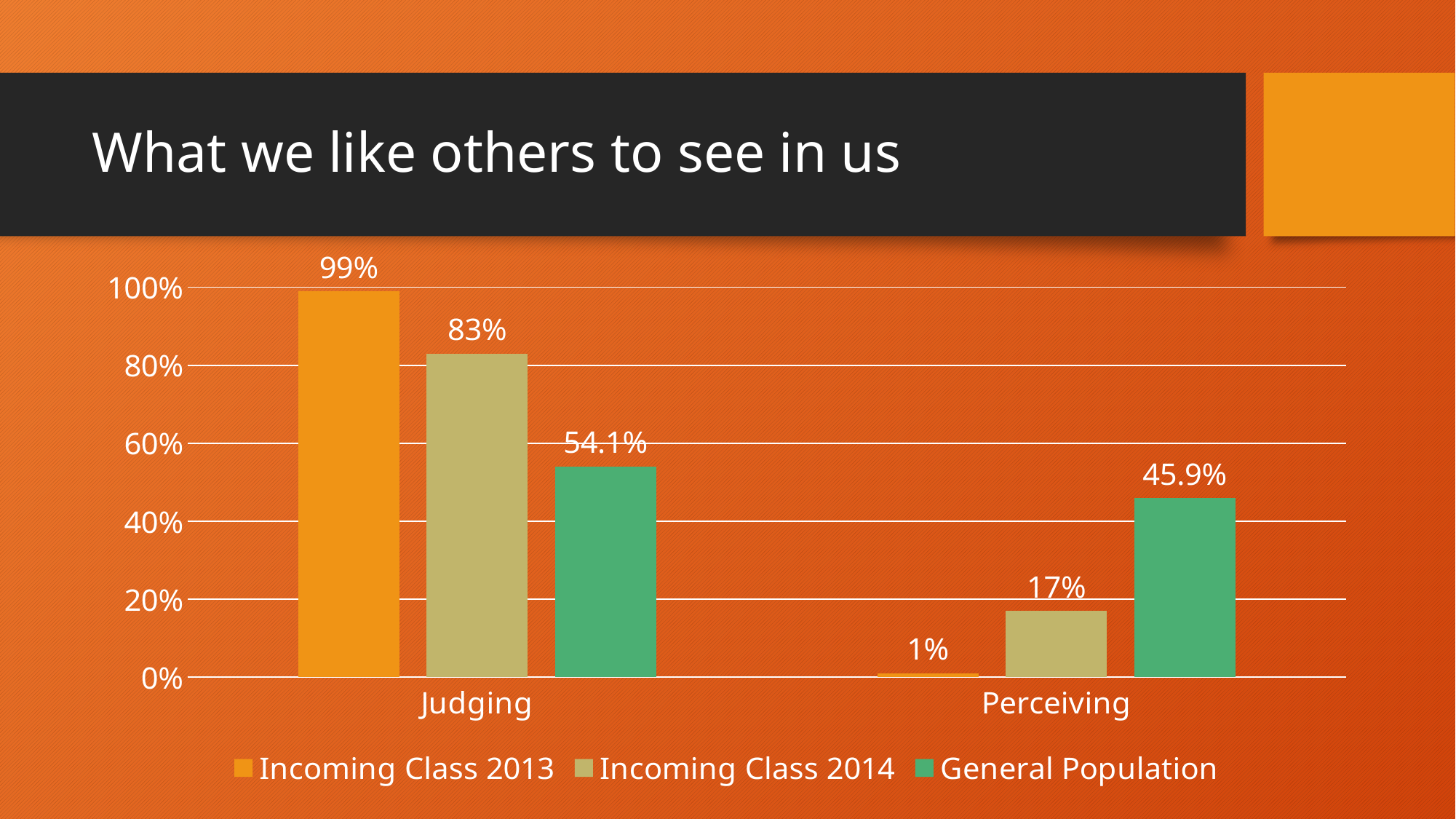
What is the value for Incoming Class 2014 in the Perceiving category? 17% What is the difference between the General Population values for Judging and Perceiving? 8.2% Which series has the lowest value in the Perceiving category? Incoming Class 2013 What is the value for General Population in the Perceiving category? 45.9% What is the difference between the Incoming Class 2013 and Incoming Class 2014 values for Judging? 16% What is the value for Incoming Class 2013 in the Judging category? 99% How many categories are shown on the x axis? 2 Which series has the highest value in the Judging category? Incoming Class 2013 Is the General Population value for Perceiving greater or less than 40%? greater How many series does the legend list? 3 What kind of chart is shown on the slide? Bar chart Which is larger: the Incoming Class 2014 value for Judging or the General Population value for Judging? Incoming Class 2014